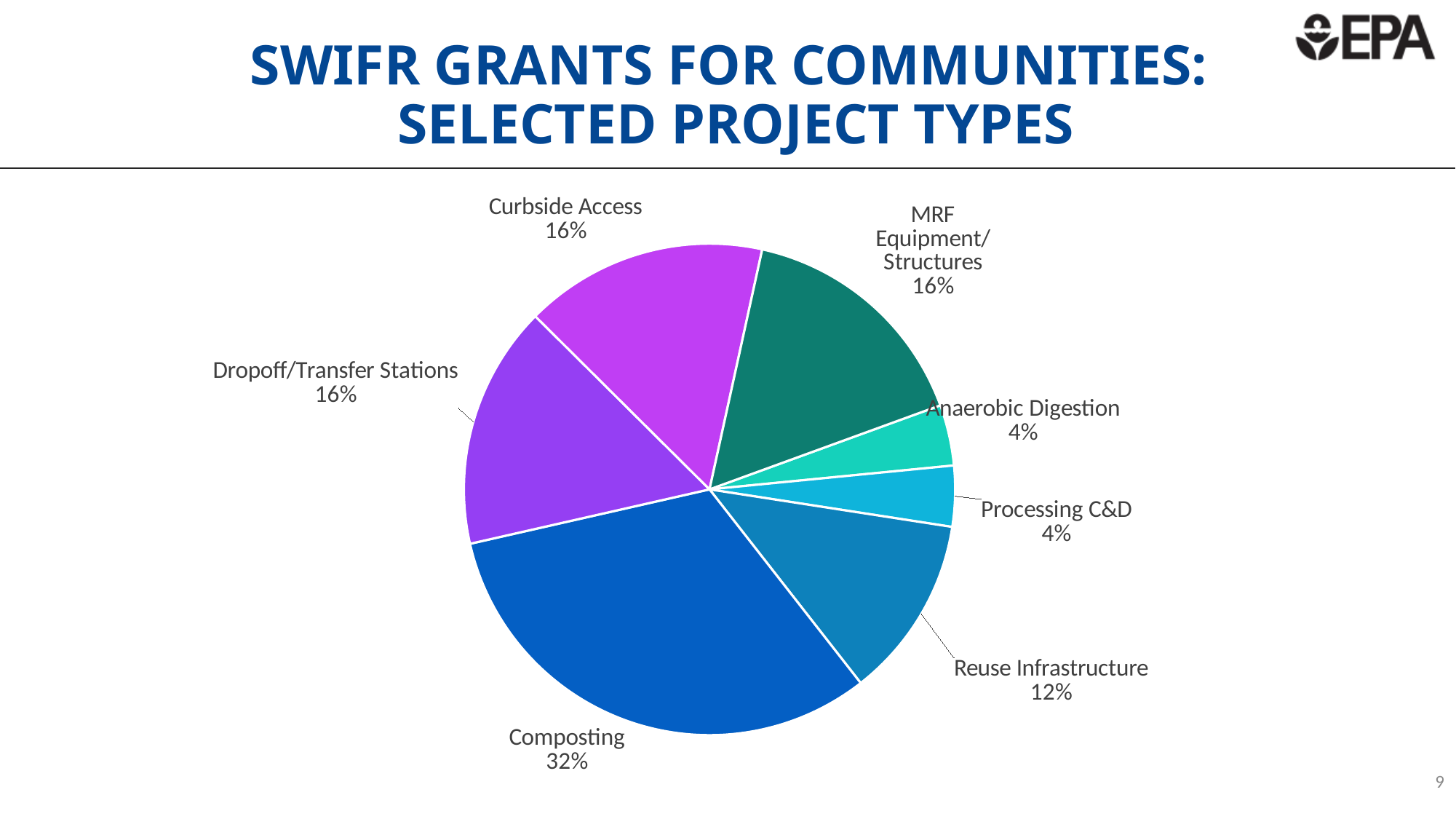
What is the title of the slide containing the pie chart? SWIFR Grants for Communities: Selected Project Types What is the value shown for Anaerobic Digestion? 4% Which is larger, the share for Dropoff/Transfer Stations or the share for Processing C&D? Dropoff/Transfer Stations How many project types are shown with a share of 16%? 3 What is the value shown for Curbside Access? 16% What is the value shown for Reuse Infrastructure? 12% What is the difference between the Curbside Access share and the Anaerobic Digestion share? 12% How many slices does the pie chart have? 7 Which project type has the largest slice of the pie? Composting What is the difference between the Composting share and the Reuse Infrastructure share? 20% What share of the pie does Composting represent? 32% What kind of chart is shown on the slide? pie chart